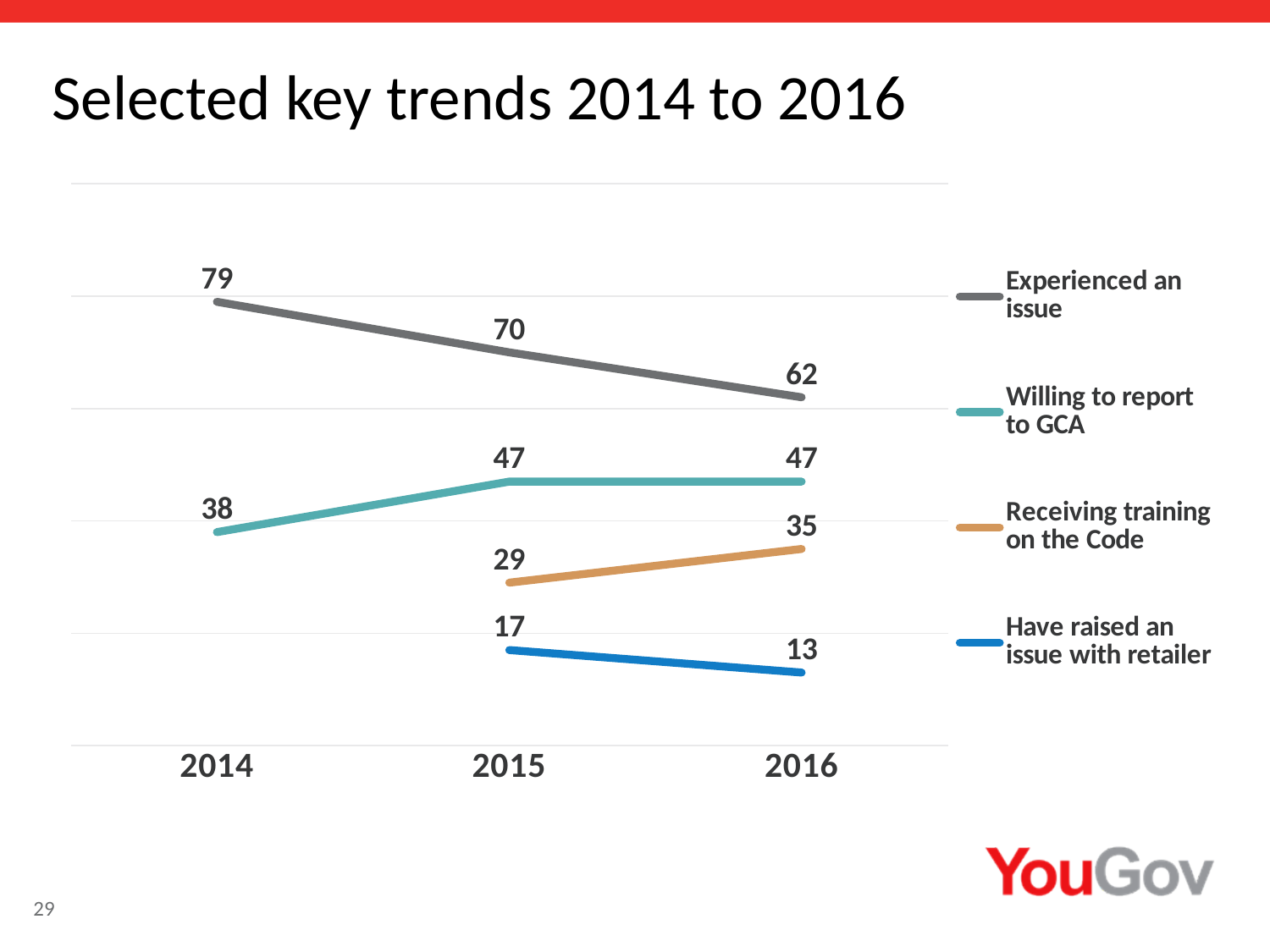
Which series has the lowest value in 2015? Have raised an issue with retailer Which is larger in 2015: "Willing to report to GCA" or "Receiving training on the Code"? Willing to report to GCA What is the value for "Willing to report to GCA" in 2016? 47 Does the "Experienced an issue" series rise or fall from 2014 to 2016? Fall What is the value for "Experienced an issue" in 2014? 79 What kind of chart is shown on the slide? Line chart Which series has the highest value in 2016? Experienced an issue What is the value for "Have raised an issue with retailer" in 2016? 13 How many series does the legend list? 4 What is the difference between "Willing to report to GCA" and "Receiving training on the Code" in 2016? 12 What is the value for "Receiving training on the Code" in 2015? 29 By how much did "Experienced an issue" fall from 2014 to 2016? 17